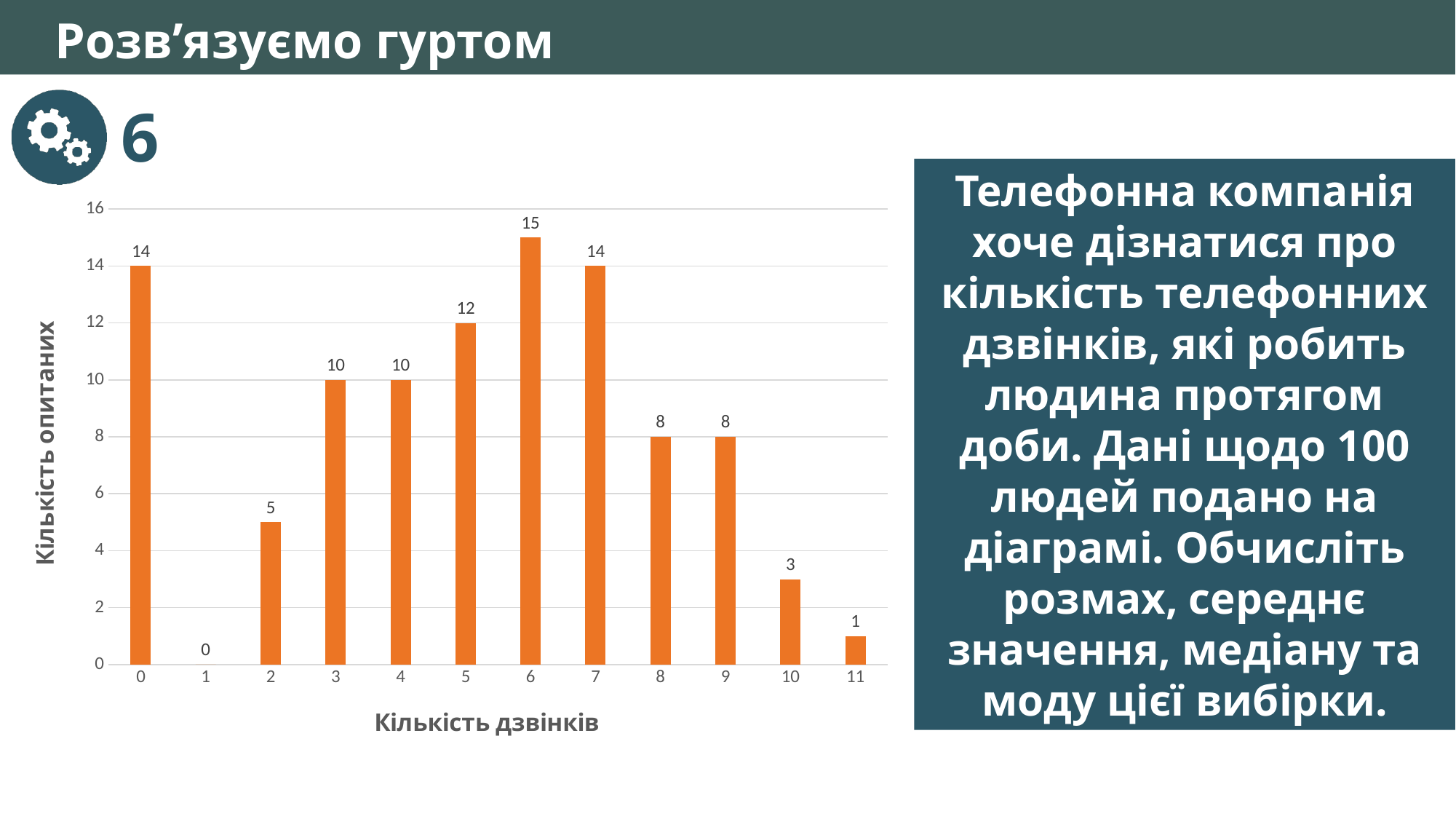
What is the label of the vertical axis of the chart? Кількість опитаних Which number of calls has the highest number of respondents? 6 What is the difference between the number of respondents for 6 calls and for 10 calls? 12 What kind of chart is shown on the slide? Bar chart How many categories (numbers of calls) are shown on the x axis? 12 How many respondents made 10 calls? 3 Which number of calls has the lowest number of respondents? 1 What is the value shown for 2 calls (category "2" on the x axis)? 5 Do the values rise or fall along the x axis from 7 calls to 11 calls? Fall Is the value for 7 calls greater or less than 12? greater How many respondents made 6 calls per day according to the chart? 15 Which has more respondents: 5 calls or 8 calls? 5 calls